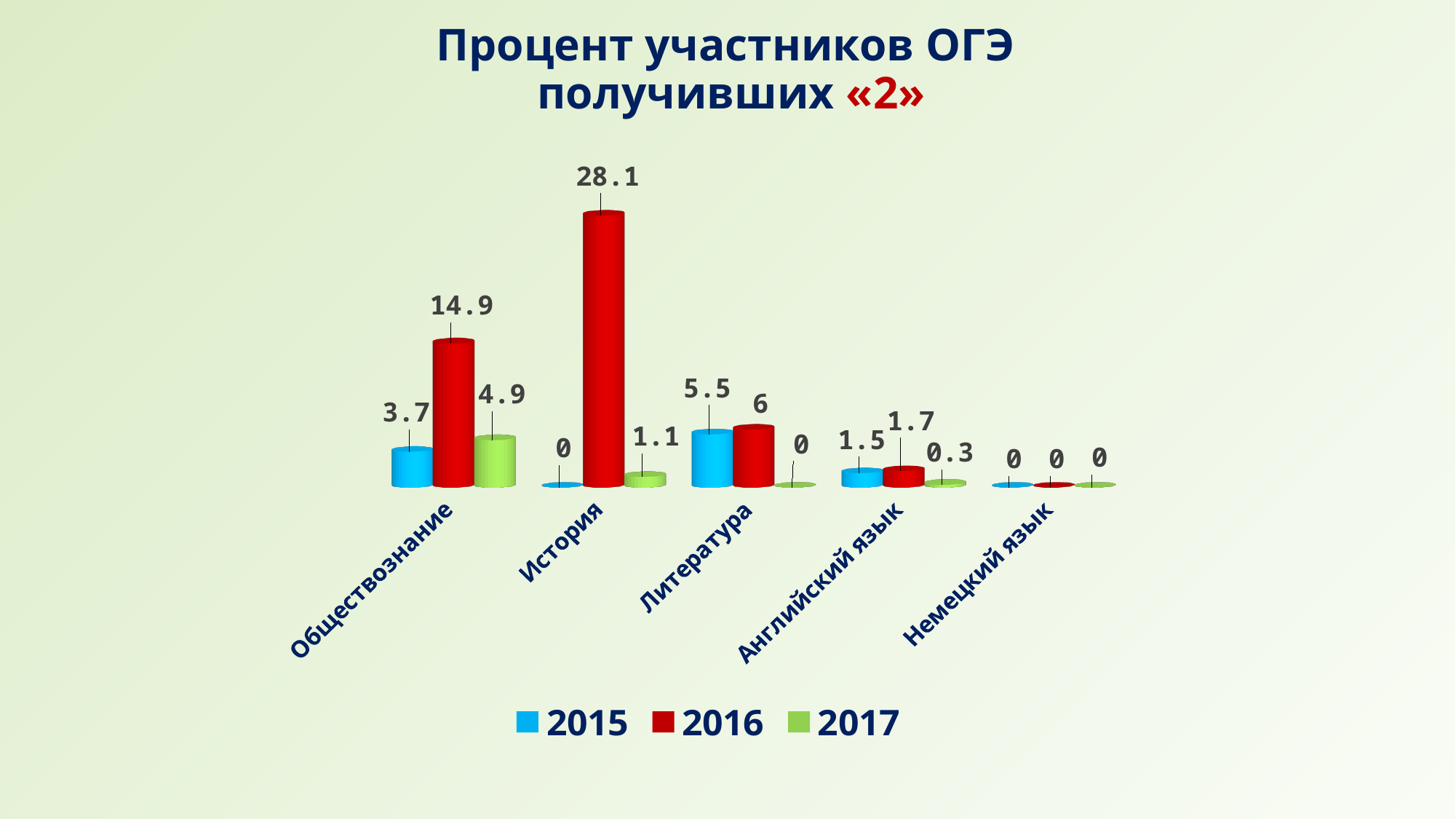
How many series does the legend list? 3 Which subject has the highest value in 2016? История What is the value for Литература in 2015? 5.5 Which subject has the highest value in 2015? Литература Which colour represents 2017 in the legend? Green How many subjects are shown on the x axis? 5 What is the value for История in 2016? 28.1 What is the difference between the 2016 and 2015 values for Обществознание? 11.2 Which is larger for Литература: the 2015 value or the 2016 value? 2016 What kind of chart is shown on the slide? Bar chart What is the value for Английский язык in 2017? 0.3 What is the value for Обществознание in 2017? 4.9